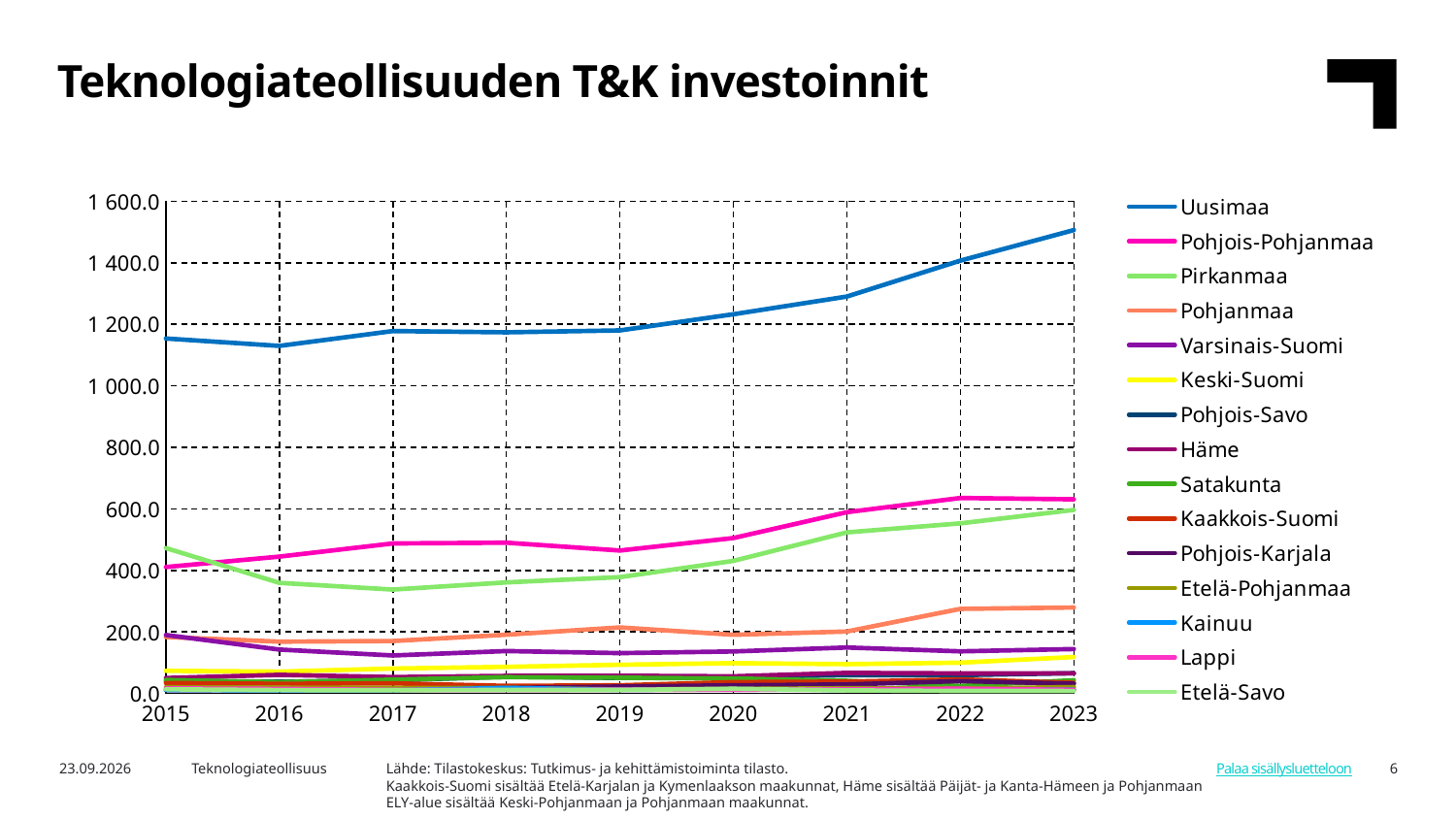
Is the value for Uusimaa in 2023 greater or less than 1 400.0? greater What is the title of the chart? Teknologiateollisuuden T&K investoinnit Which is larger in 2016, Pohjois-Pohjanmaa or Pirkanmaa? Pohjois-Pohjanmaa Is the value for Uusimaa in 2016 greater or less than 1 200.0? less Does the Uusimaa line rise or fall between 2019 and 2023? rise Which series is listed first in the legend? Uusimaa Is the value for Pirkanmaa in 2017 greater or less than 400.0? less Which series has the highest value in 2023? Uusimaa How many years are shown along the x axis? 9 How many series does the legend list? 15 What kind of chart is shown on the slide? line chart